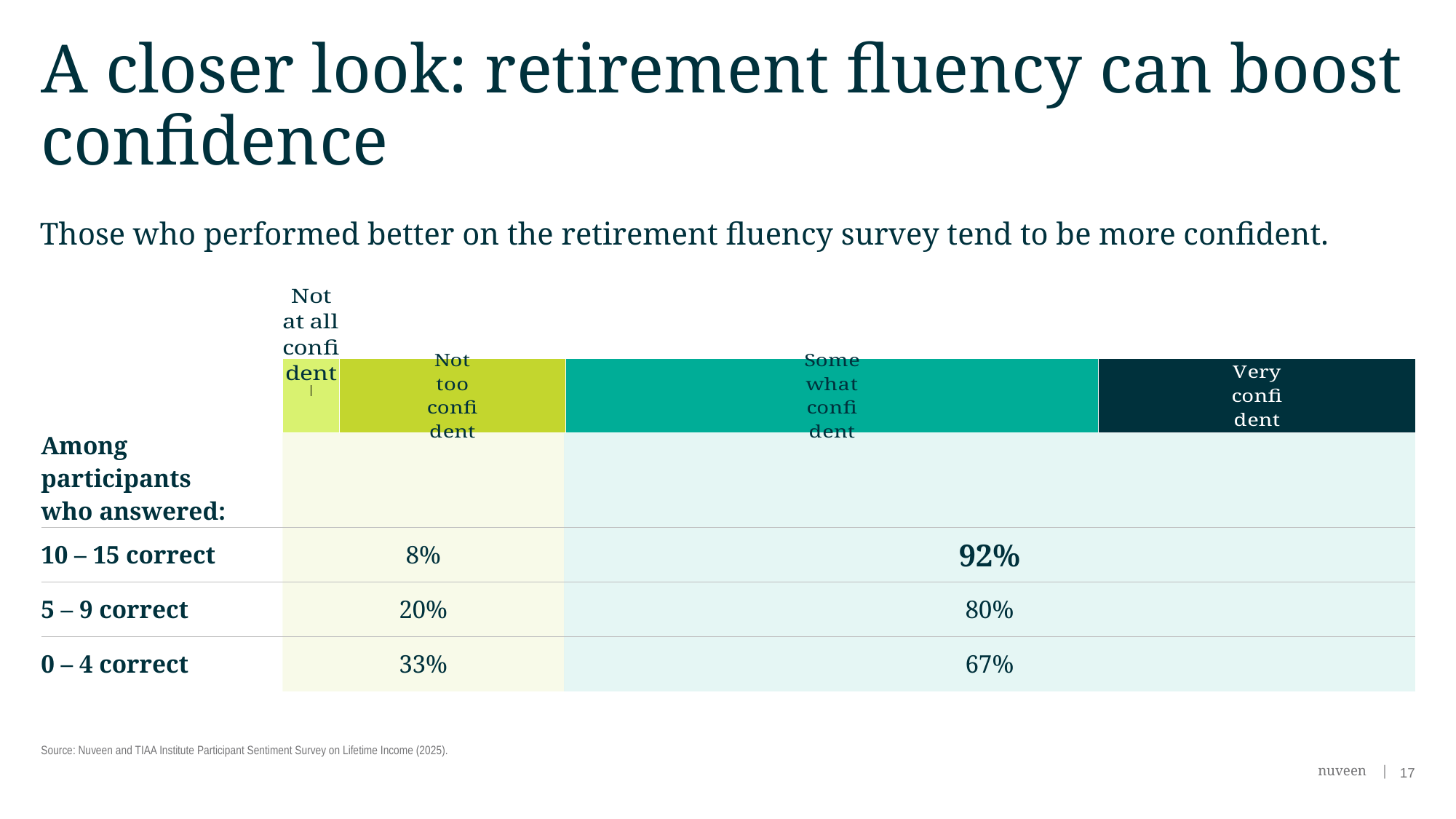
Which confidence segment is the widest in the stacked bar? Somewhat confident Which group of participants has the highest share who are confident? 10 – 15 correct What colour is the 'Very confident' segment of the stacked bar? dark teal What kind of chart is shown on the slide? bar chart How many confidence segments make up the stacked bar? 4 Does the confident share rise or fall as the number of correct answers decreases from 10–15 to 0–4? fall What percentage of participants who answered 0–4 correct are not confident? 33% What percentage of participants who answered 5–9 correct are confident? 80% What is the difference in the confident share between the 10–15 correct group and the 0–4 correct group? 25% Is the 'Somewhat confident' segment wider or narrower than the 'Very confident' segment? wider Which confidence segment is the narrowest in the stacked bar? Not at all confident What percentage of participants who answered 10–15 correct are confident? 92%